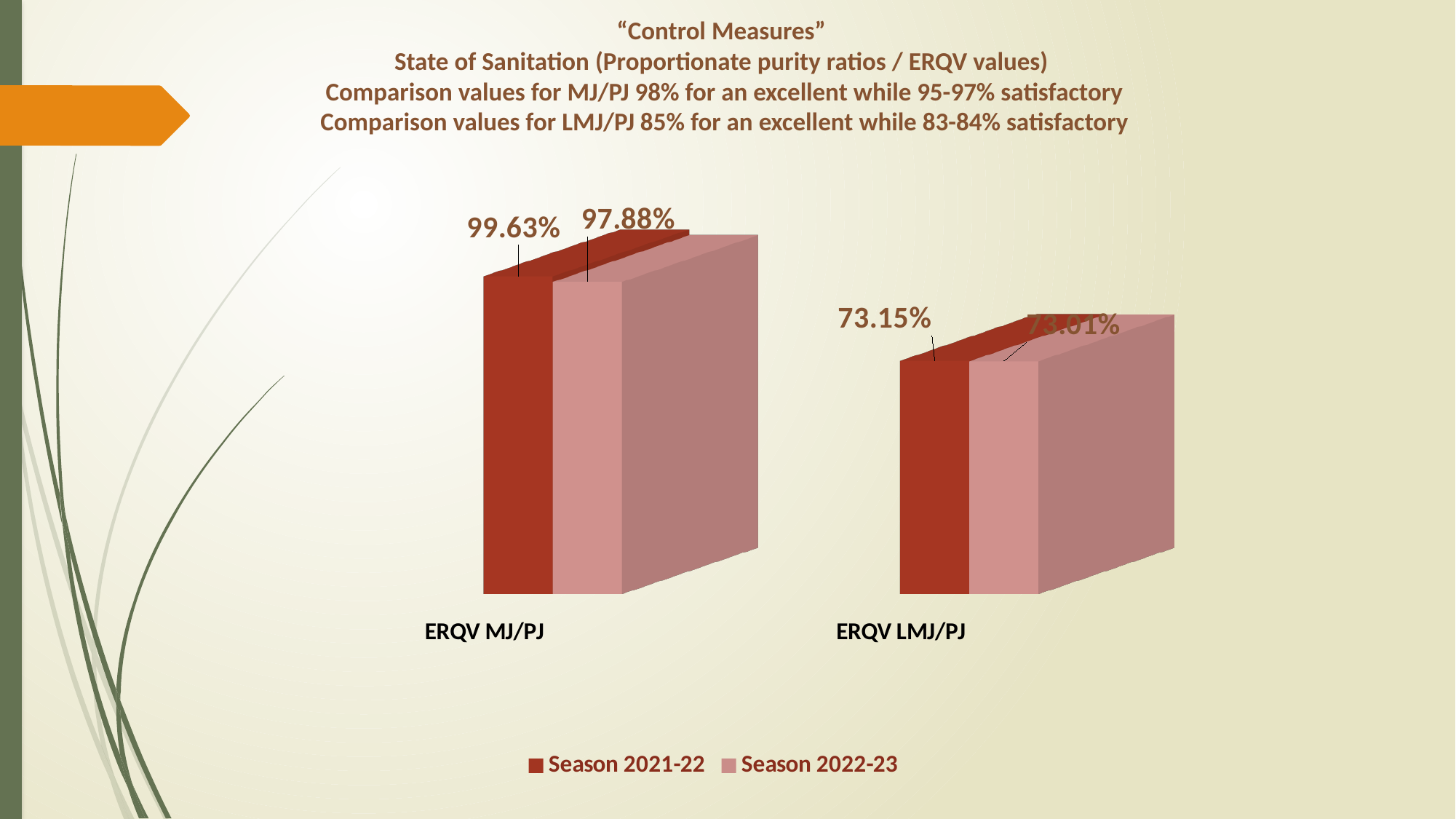
Which category has the lowest value in Season 2022-23? ERQV LMJ/PJ What is the value for ERQV LMJ/PJ in Season 2021-22? 73.15% What is the value for ERQV LMJ/PJ in Season 2022-23? 73.01% What is the difference between the Season 2021-22 values for ERQV MJ/PJ and ERQV LMJ/PJ? 26.48% What kind of chart is shown on the slide? Bar chart How many series does the legend list? 2 What is the difference between the Season 2021-22 and Season 2022-23 values for ERQV MJ/PJ? 1.75% What is the value for ERQV MJ/PJ in Season 2022-23? 97.88% Which is larger in Season 2022-23: ERQV MJ/PJ or ERQV LMJ/PJ? ERQV MJ/PJ What is the value for ERQV MJ/PJ in Season 2021-22? 99.63% How many categories are shown on the x axis of the chart? 2 Which category has the highest value in Season 2021-22? ERQV MJ/PJ